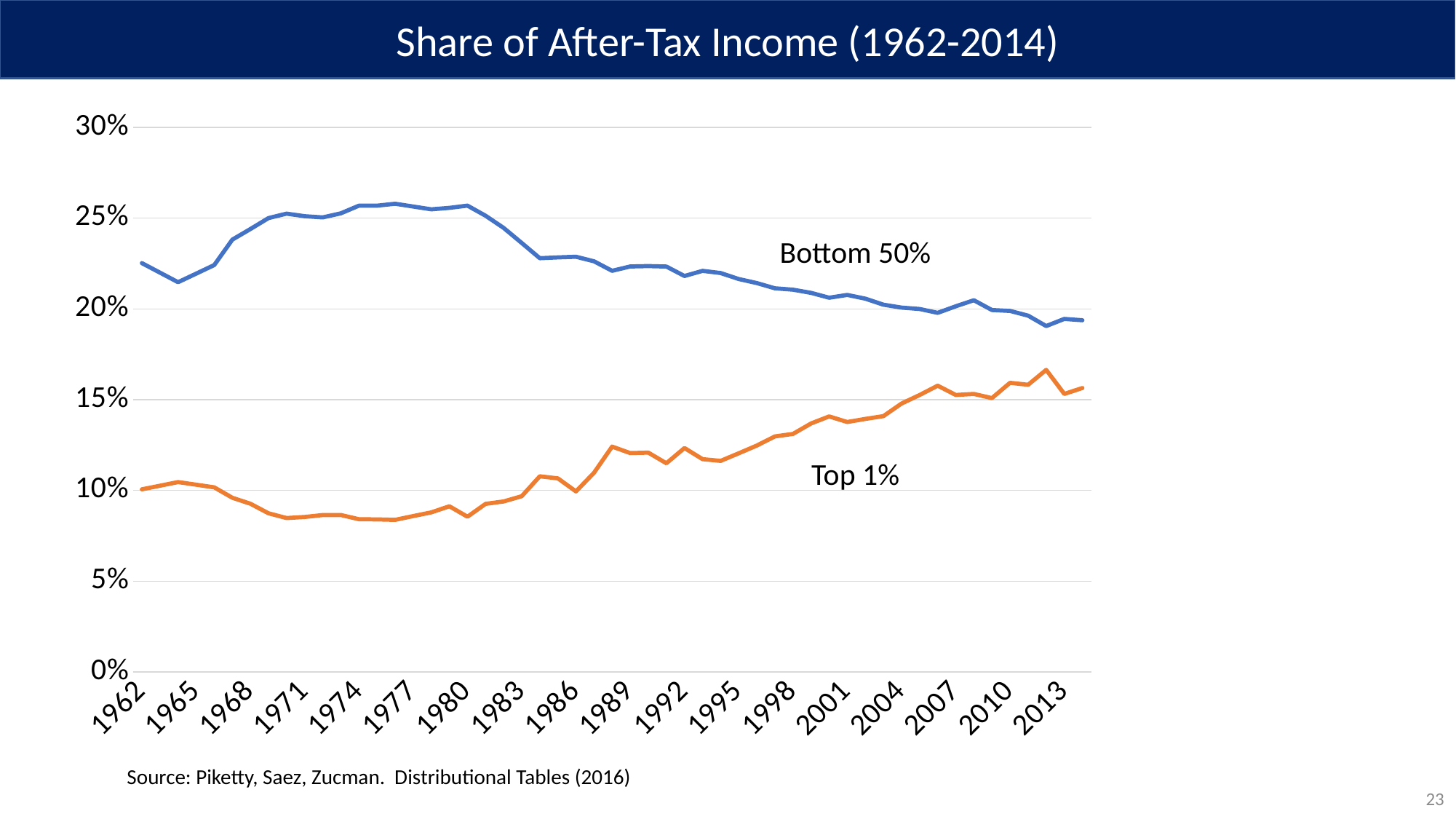
How many series are plotted on the chart? 2 In 1962, which series has the larger value, Bottom 50% or Top 1%? Bottom 50% Does the Bottom 50% series generally rise or fall from 1980 to 2014? Fall Is the value for Top 1% in 1971 greater or less than 10%? less Is the value for Bottom 50% in 2013 greater or less than 20%? less What is the title of the chart? Share of After-Tax Income (1962-2014) What kind of chart is shown on the slide? Line chart Is the value for Bottom 50% in 1977 greater or less than 25%? greater Does the Top 1% series generally rise or fall from 1980 to 2014? Rise Which two groups are plotted on the chart? Bottom 50% and Top 1%